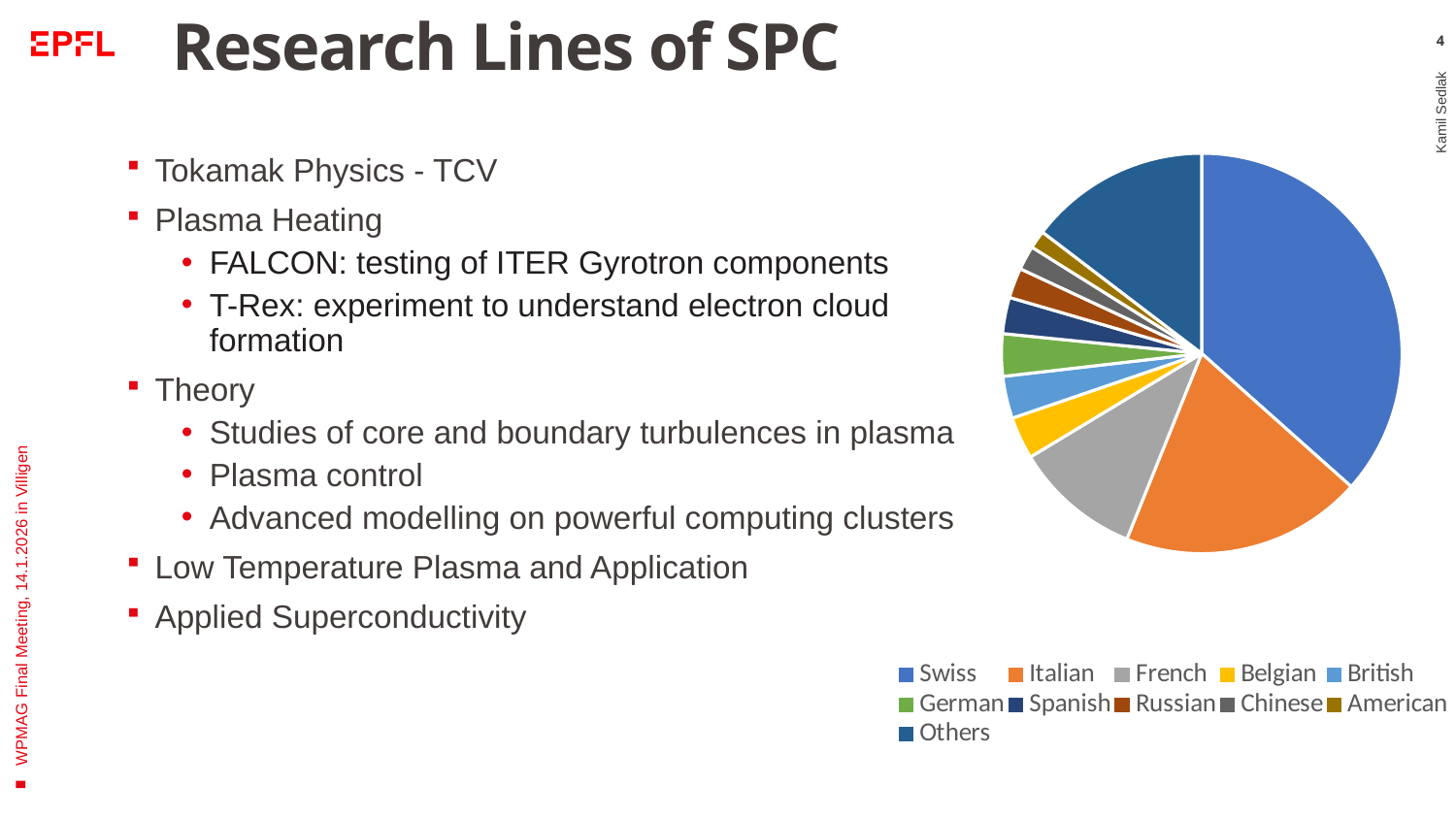
What colour is the Swiss slice in the pie chart? Blue Which slice is larger, French or Belgian? French How many categories does the pie chart's legend list? 11 Which category has the second-largest slice of the pie chart? Italian Which legend entry is listed last in the pie chart's legend? Others Which slice is larger, Italian or Others? Italian Which slice is larger, Others or German? Others What kind of chart is shown on the slide? Pie chart Which category has the largest slice of the pie chart? Swiss